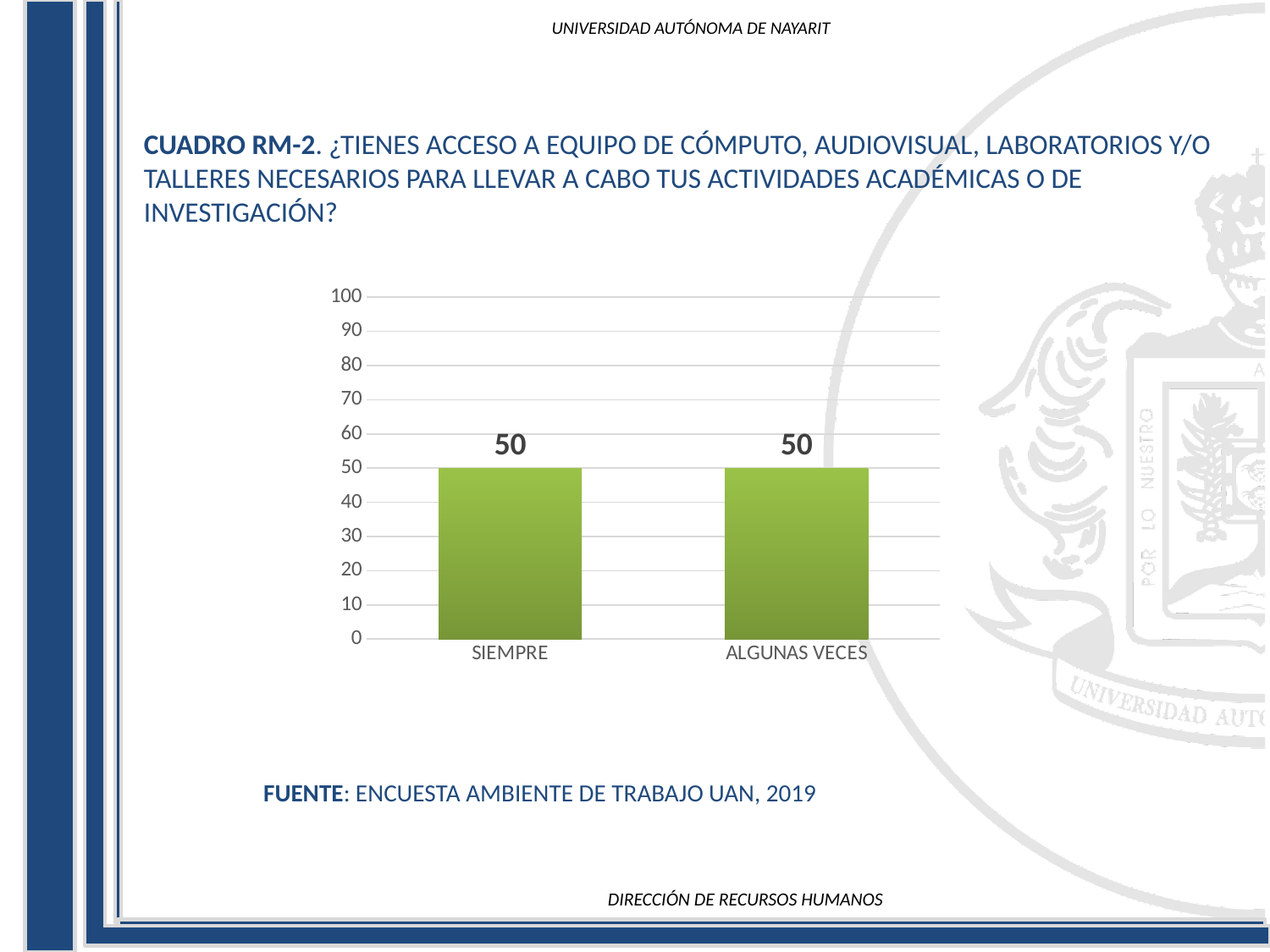
What colour are the bars in the chart? green Do the values for SIEMPRE and ALGUNAS VECES differ? No, both are 50 What is the highest value shown on the vertical axis? 100 What kind of chart is shown on the slide? bar chart Is the value for SIEMPRE greater or less than 60? less What is the difference between the values for SIEMPRE and ALGUNAS VECES? 0 How many categories are shown on the x axis? 2 Is the value for ALGUNAS VECES greater or less than 40? greater What is the value for SIEMPRE? 50 What is the value for ALGUNAS VECES? 50 What is the total of the values for SIEMPRE and ALGUNAS VECES? 100